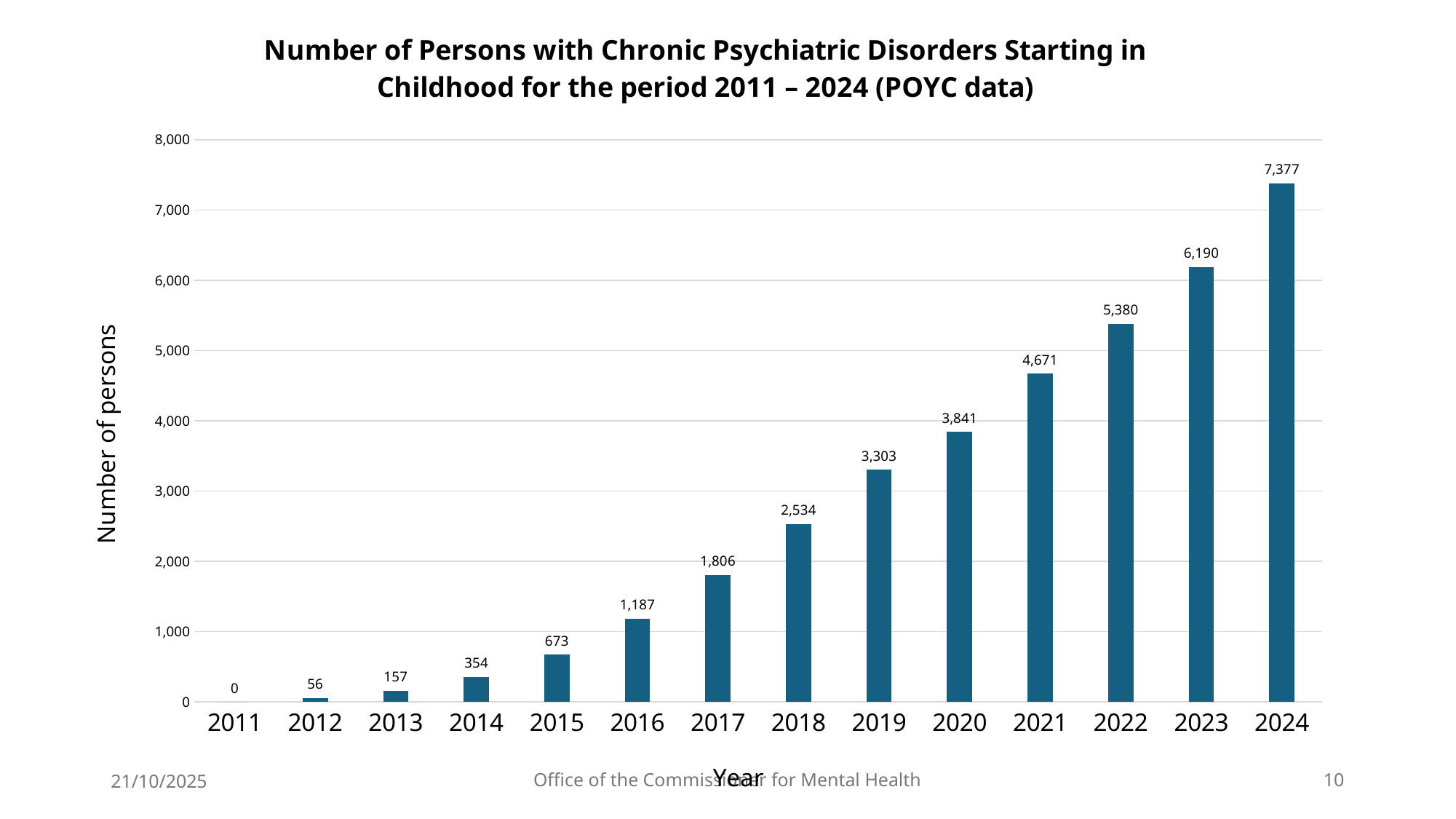
Do the values rise or fall from 2011 to 2024? Rise What is the number of persons for 2022? 5,380 Which is larger, the value for 2016 or the value for 2017? 2017 What is the number of persons for 2018? 2,534 Which year has the highest number of persons? 2024 How many years are shown on the x axis? 14 What is the difference between the values for 2020 and 2019? 538 What kind of chart is shown on the slide? Bar chart What is the number of persons for 2013? 157 Which year has the lowest number of persons? 2011 What is the difference between the values for 2024 and 2023? 1,187 Is the value for 2021 greater or less than 4,000? greater